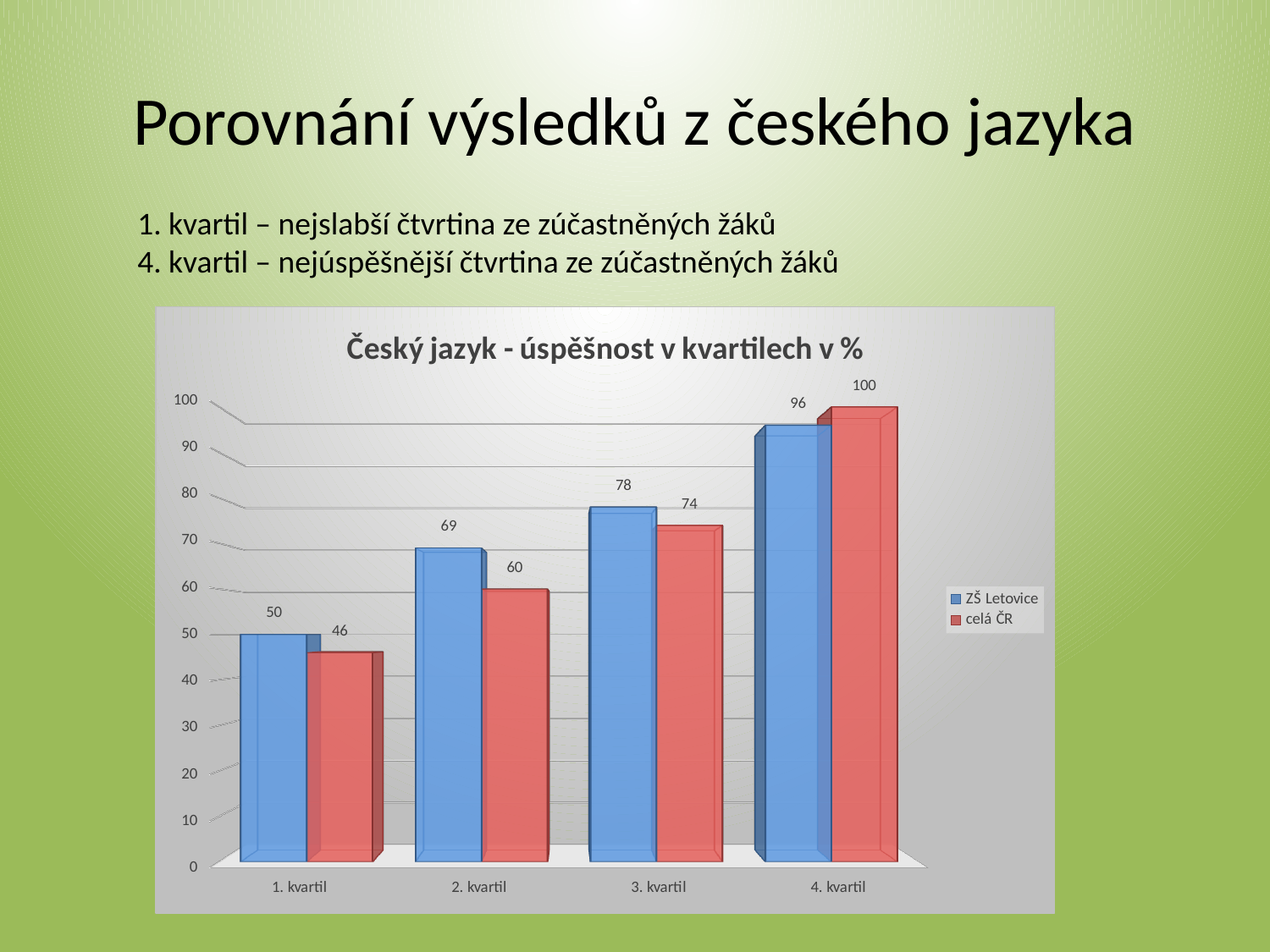
What is the difference between ZŠ Letovice and celá ČR in 2. kvartil? 9 How many series does the legend list? 2 What kind of chart is shown on the slide? bar chart What is the title of the chart? Český jazyk - úspěšnost v kvartilech v % What is the value for ZŠ Letovice in 3. kvartil? 78 Which is larger in 4. kvartil, ZŠ Letovice or celá ČR? celá ČR What is the value for celá ČR in 4. kvartil? 100 Which category has the lowest value for celá ČR? 1. kvartil What is the value for celá ČR in 2. kvartil? 60 How many categories are shown on the x axis? 4 Which category has the highest value for ZŠ Letovice? 4. kvartil What is the value for ZŠ Letovice in 1. kvartil? 50